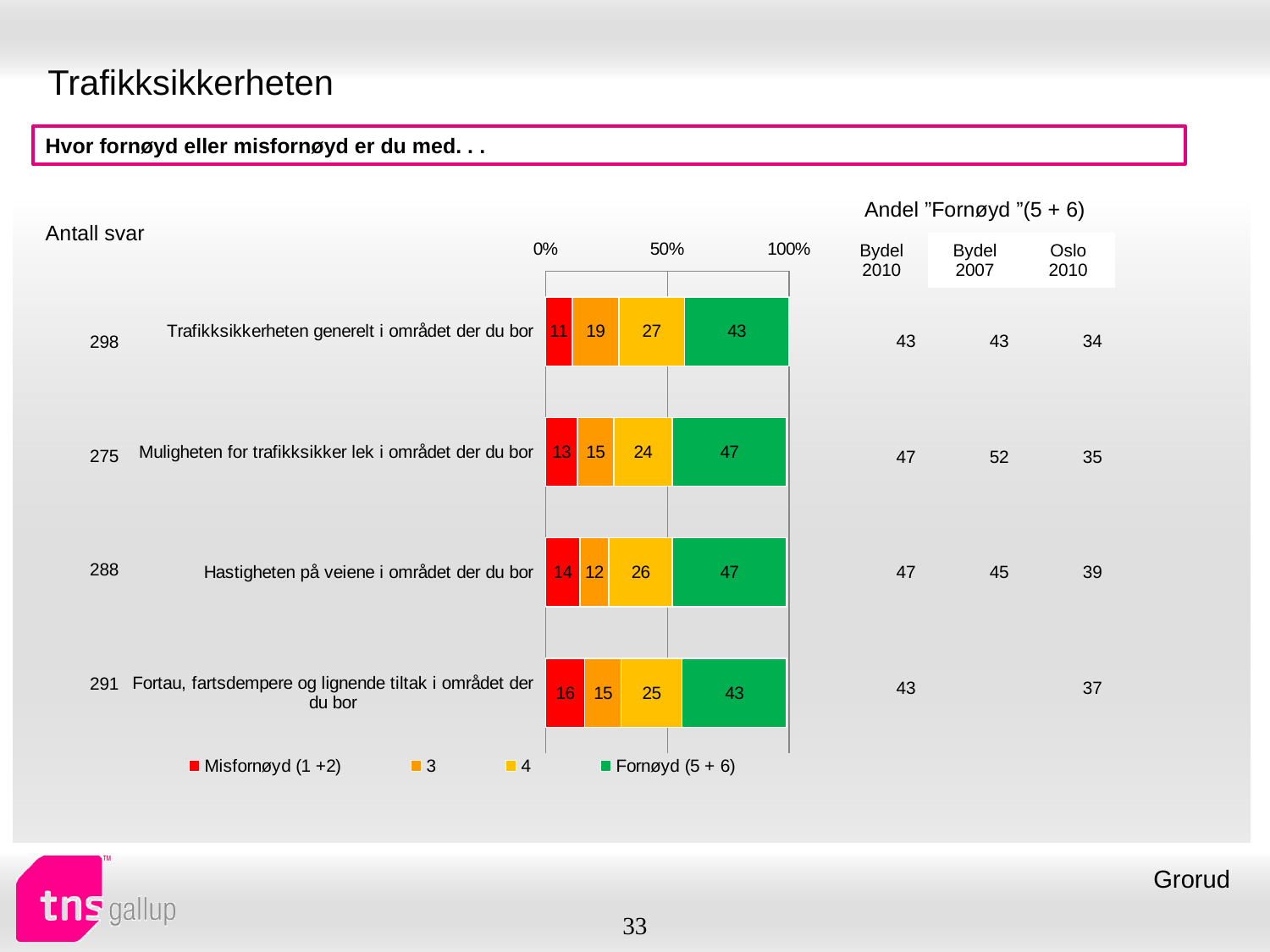
Which category has the highest Misfornøyd (1 +2) value? Fortau, fartsdempere og lignende tiltak i området der du bor Which is larger: the series '3' value for 'Trafikksikkerheten generelt i området der du bor' or for 'Hastigheten på veiene i området der du bor'? Trafikksikkerheten generelt i området der du bor What is the total of the stacked bar for 'Fortau, fartsdempere og lignende tiltak i området der du bor'? 99 What is the difference between the Fornøyd (5 + 6) values for 'Hastigheten på veiene i området der du bor' and 'Trafikksikkerheten generelt i området der du bor'? 4 What colour represents the Fornøyd (5 + 6) series in the chart? Green How many series does the legend list? 4 What is the Misfornøyd (1 +2) value for 'Hastigheten på veiene i området der du bor'? 14 What is the Fornøyd (5 + 6) value for 'Trafikksikkerheten generelt i området der du bor'? 43 How many categories are plotted in the chart? 4 Which category has the lowest Misfornøyd (1 +2) value? Trafikksikkerheten generelt i området der du bor What kind of chart is shown on the slide? Stacked bar chart What is the value of series '4' for 'Muligheten for trafikksikker lek i området der du bor'? 24